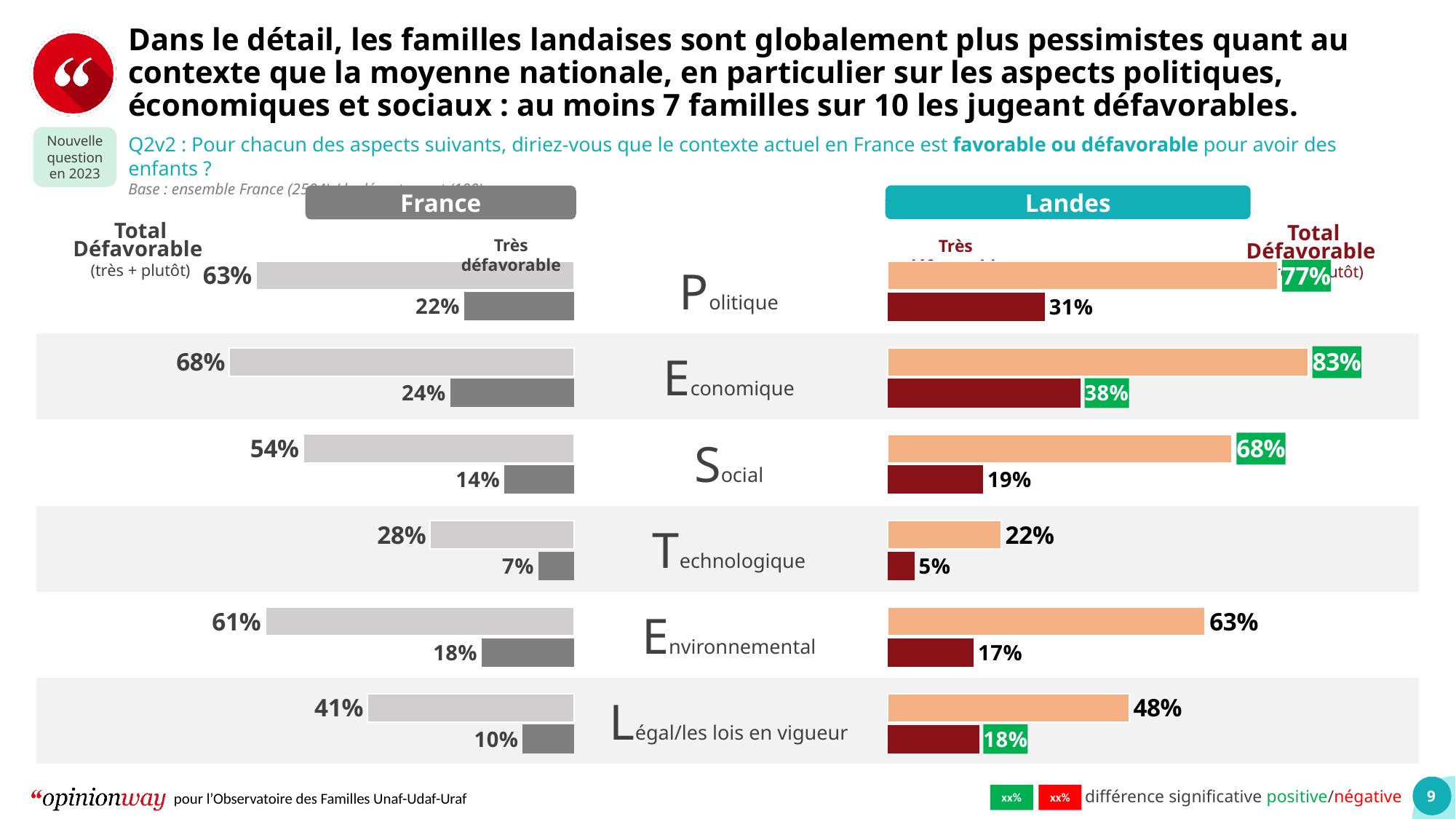
In the France chart, what is the Total Défavorable value for Economique? 68% Which is larger: the Total Défavorable value for Environnemental in the France chart or in the Landes chart? Landes In the Landes chart, what is the Très défavorable value for Politique? 31% In the France chart, which aspect has the lowest Total Défavorable value? Technologique What type of chart is used on this slide? Bar chart In the Landes chart, which aspect has the highest Total Défavorable value? Economique How many series does each chart show per aspect? 2 How many aspects (categories) are shown in each chart? 6 In the Landes chart, what is the Total Défavorable value for Légal/les lois en vigueur? 48% In the Landes chart, what is the difference between the Total Défavorable and Très défavorable values for Social? 49 points In the France chart, what is the Très défavorable value for Technologique? 7% What is the difference between the Total Défavorable value for Politique in the Landes chart and in the France chart? 14 points